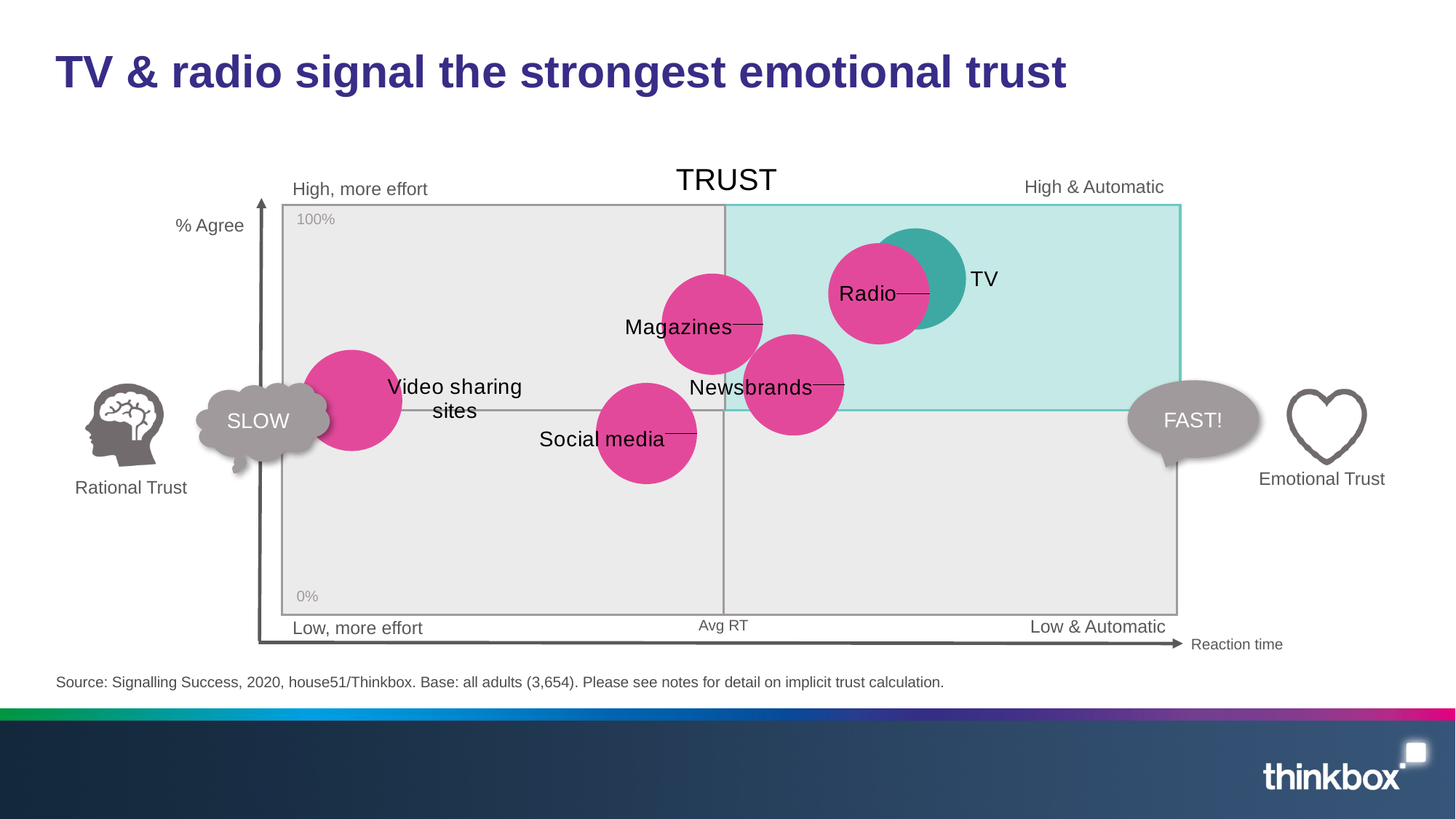
Is the Social media bubble to the left or right of the Avg RT line? Left Which category is positioned furthest to the left (slowest reaction time) on the chart? Video sharing sites What is the label of the vertical axis of the chart? % Agree Which category has the lowest % Agree on the chart? Social media Which has a higher % Agree, Magazines or Social media? Magazines Which has a faster reaction time (further right), Newsbrands or Social media? Newsbrands Which category is positioned furthest to the right (fastest reaction time) on the chart? TV What is the label of the horizontal axis of the chart? Reaction time What kind of chart is shown on the slide? Bubble (scatter) chart How many media categories are plotted as bubbles on the chart? 6